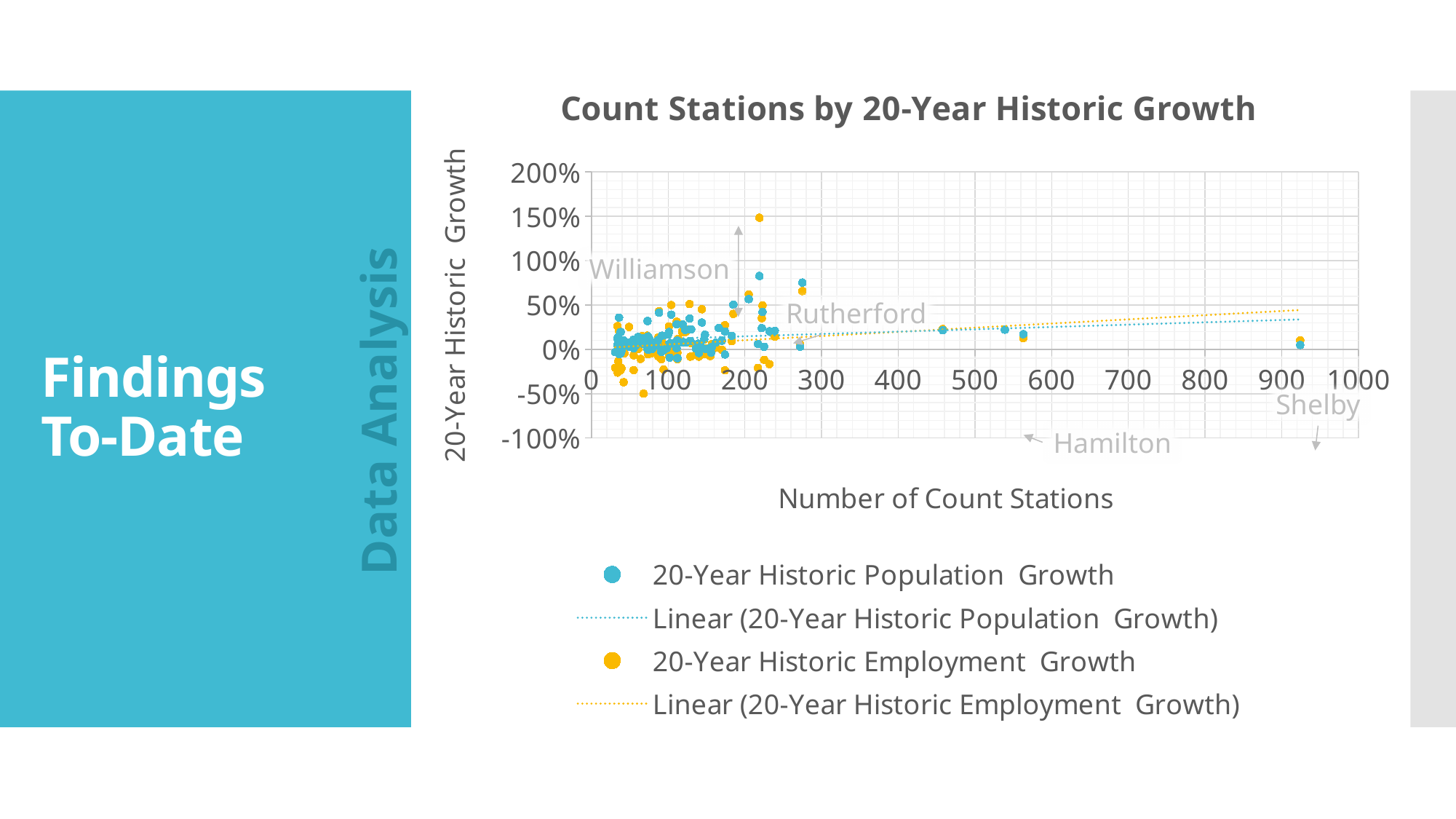
Which county label is placed at the far right of the chart near 900 count stations? Shelby What is the title of the chart? Count Stations by 20-Year Historic Growth Which series contains the single highest point on the chart, population growth or employment growth? 20-Year Historic Employment Growth What kind of chart is shown on the slide? scatter chart Is the lowest employment growth point on the chart greater or less than 0%? less Is the 20-year historic growth for the Shelby points greater or less than 50%? less Is the number of count stations for the point labelled Shelby greater or less than 900? greater What is the label of the horizontal axis? Number of Count Stations Do the dotted linear trend lines rise or fall as the number of count stations increases? rise How many entries does the chart legend list? 4